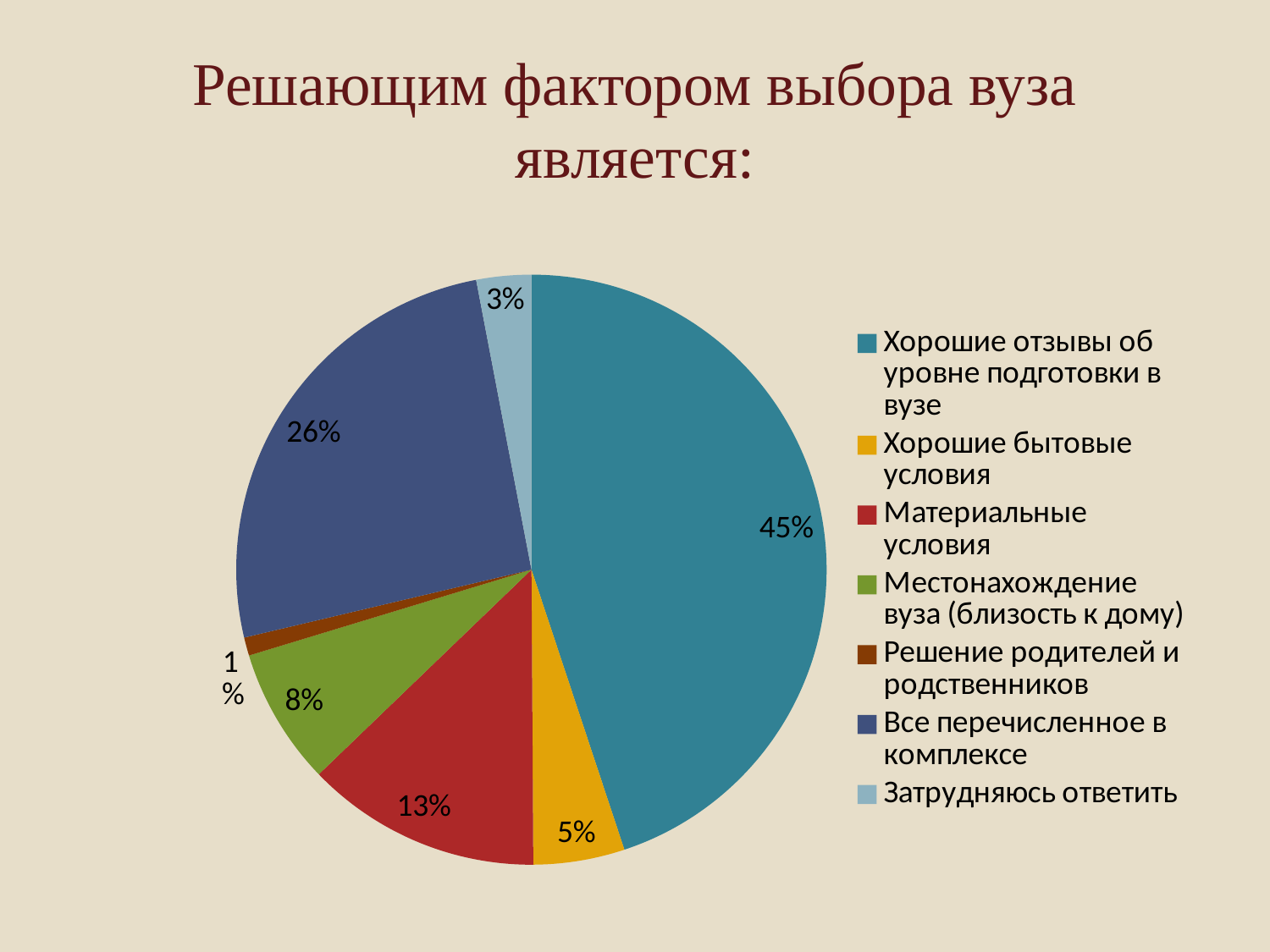
What is the difference in percentage points between "Хорошие отзывы об уровне подготовки в вузе" and "Все перечисленное в комплексе"? 19 What share of the pie is labelled for "Местонахождение вуза (близость к дому)"? 8% How many categories does the legend list? 7 What share of the pie is labelled for "Хорошие отзывы об уровне подготовки в вузе"? 45% Which is larger: the slice for "Материальные условия" or the slice for "Хорошие бытовые условия"? Материальные условия Which category has the smallest slice of the pie? Решение родителей и родственников What is the title of the slide? Решающим фактором выбора вуза является: What share of the pie is labelled for "Все перечисленное в комплексе"? 26% What share of the pie is labelled for "Материальные условия"? 13% What kind of chart is shown on the slide? pie chart What share of the pie is labelled for "Затрудняюсь ответить"? 3% Which category has the largest slice of the pie? Хорошие отзывы об уровне подготовки в вузе